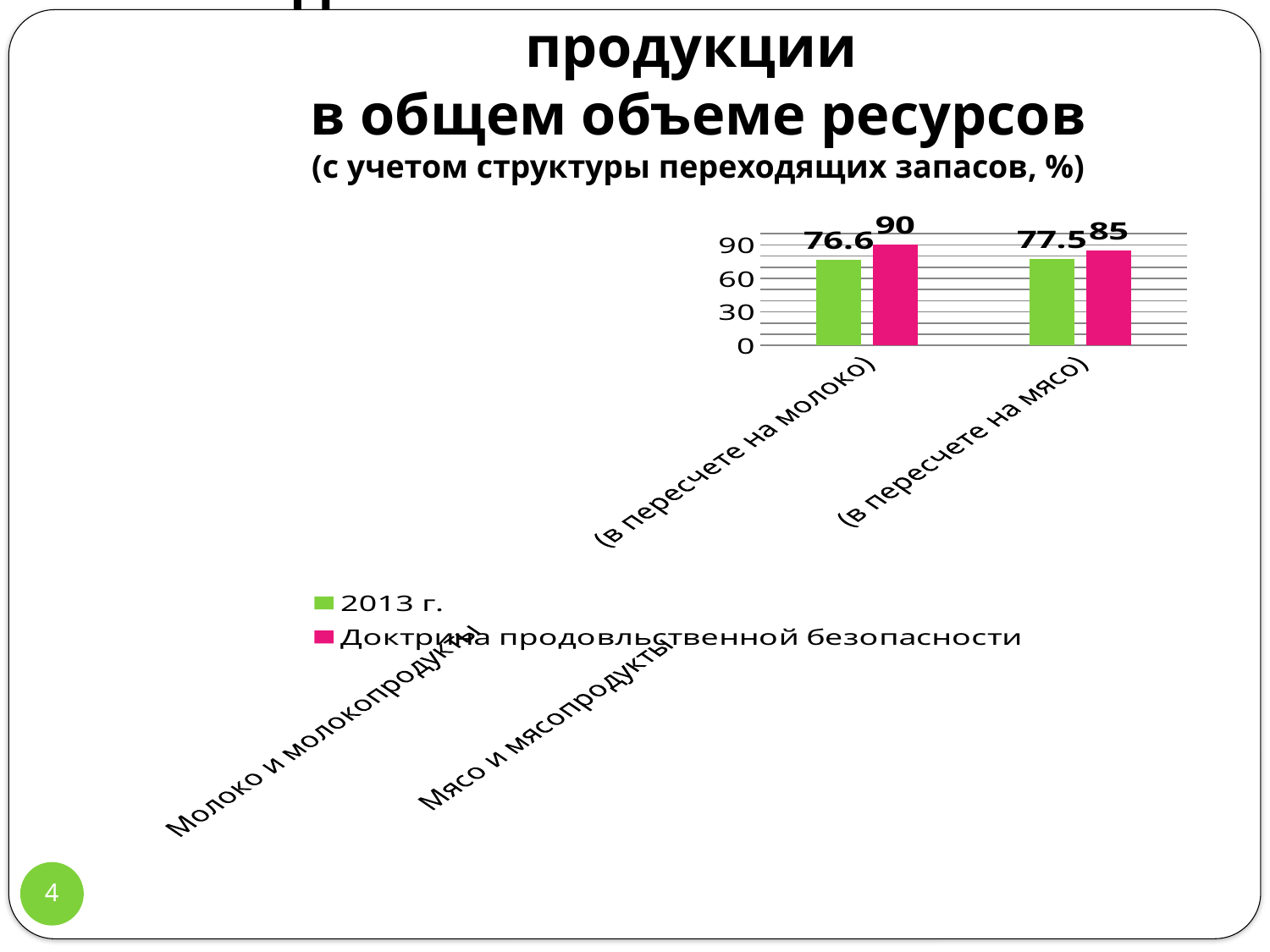
What is the value for Доктрина продовольственной безопасности for Мясо и мясопродукты (в пересчете на мясо)? 85 Is the 2013 г. value for Молоко и молокопродукты (в пересчете на молоко) greater or less than 60? greater Which category has the highest value in the Доктрина продовольственной безопасности series? Молоко и молокопродукты (в пересчете на молоко) How many categories are shown on the x axis of the chart? 2 How many series does the legend list? 2 What is the difference between the Доктрина продовольственной безопасности value and the 2013 г. value for Молоко и молокопродукты (в пересчете на молоко)? 13.4 What kind of chart is shown on the slide? bar chart Which is larger for Мясо и мясопродукты (в пересчете на мясо): the 2013 г. value or the Доктрина продовольственной безопасности value? Доктрина продовольственной безопасности What is the difference between the Доктрина продовольственной безопасности value and the 2013 г. value for Мясо и мясопродукты (в пересчете на мясо)? 7.5 What is the value for 2013 г. for Молоко и молокопродукты (в пересчете на молоко)? 76.6 What is the value for Доктрина продовольственной безопасности for Молоко и молокопродукты (в пересчете на молоко)? 90 What is the value for 2013 г. for Мясо и мясопродукты (в пересчете на мясо)? 77.5